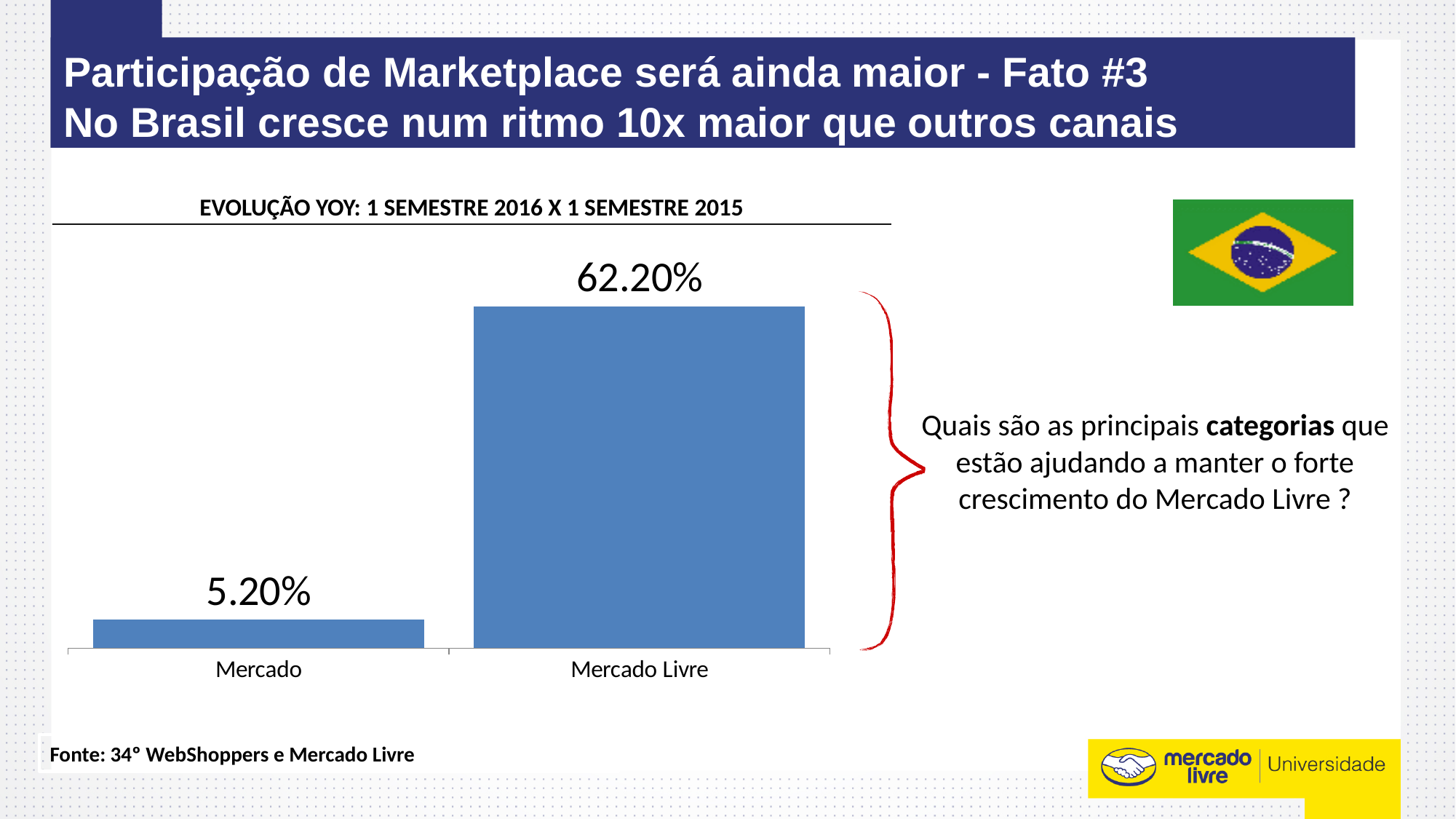
Which category has the highest value? Mercado Livre How many categories are shown in the chart? 2 What is the value for Mercado Livre? 62.20% Which is larger, the value for Mercado or the value for Mercado Livre? Mercado Livre What kind of chart is shown on the slide? Bar chart What is the difference between the values for Mercado Livre and Mercado? 57.00% What colour are the bars in the chart? Blue What is the value for Mercado? 5.20% What is the title of the chart? EVOLUÇÃO YOY: 1 SEMESTRE 2016 X 1 SEMESTRE 2015 Which category has the lowest value? Mercado